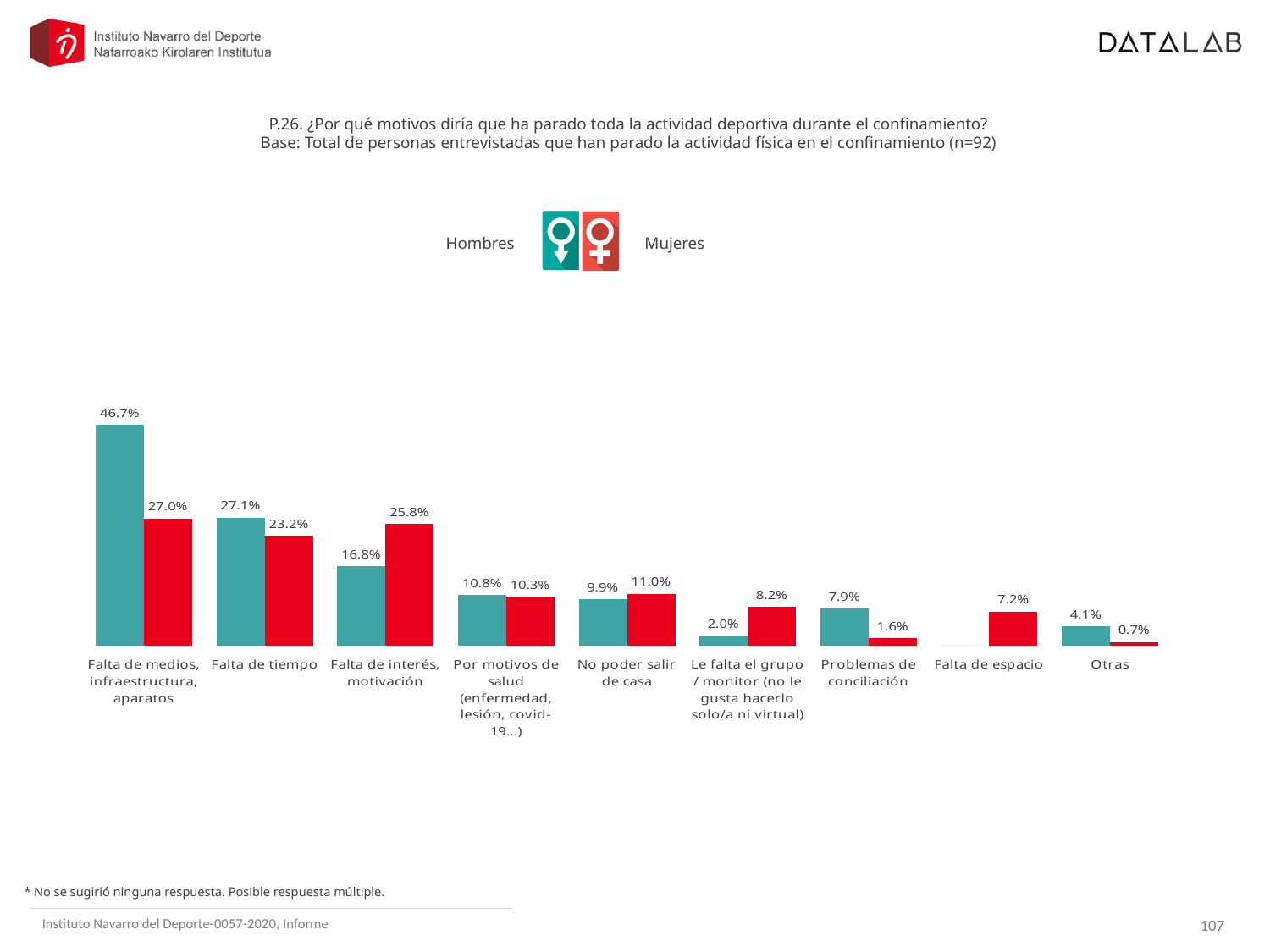
How many categories are shown on the x axis of the chart? 9 Which category has the lowest value for Mujeres? Otras What is the value for Mujeres in the 'Falta de interés, motivación' category? 25.8% Which category has the highest value for Hombres? Falta de medios, infraestructura, aparatos What is the value for Hombres in the 'Falta de medios, infraestructura, aparatos' category? 46.7% In the 'Falta de tiempo' category, which is larger, the Hombres value or the Mujeres value? Hombres What kind of chart is shown on the slide? Bar chart What is the difference between the Hombres and Mujeres values in the 'Falta de medios, infraestructura, aparatos' category? 19.7% What is the value for Mujeres in the 'Problemas de conciliación' category? 1.6% How many series does the chart show? 2 In the 'No poder salir de casa' category, which is larger, the Hombres value or the Mujeres value? Mujeres What is the difference between the Mujeres and Hombres values in the 'Le falta el grupo / monitor (no le gusta hacerlo solo/a ni virtual)' category? 6.2%